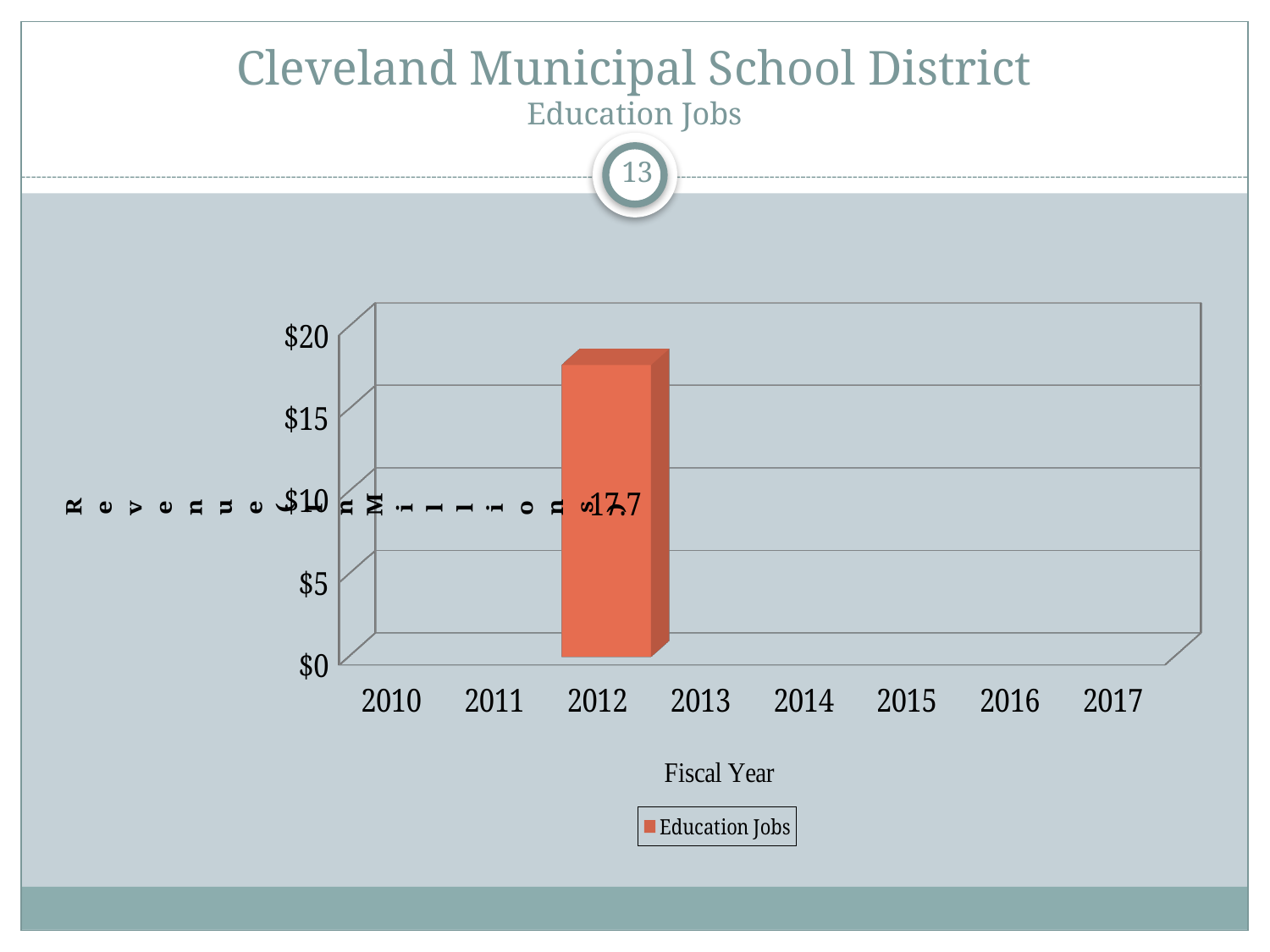
What is the value of the Education Jobs bar for fiscal year 2012? 17.7 How many series does the legend list? 1 What series name is shown in the legend? Education Jobs Which fiscal year has the larger Education Jobs value, 2012 or 2013? 2012 What kind of chart is shown on the slide? bar chart Is the value for 2012 greater or less than $15? greater How many bars are plotted on the chart? 1 Which fiscal year has the highest Education Jobs value? 2012 Is the value for 2012 greater or less than $20? less What is the title of the x axis? Fiscal Year How many fiscal years are shown on the x axis? 8